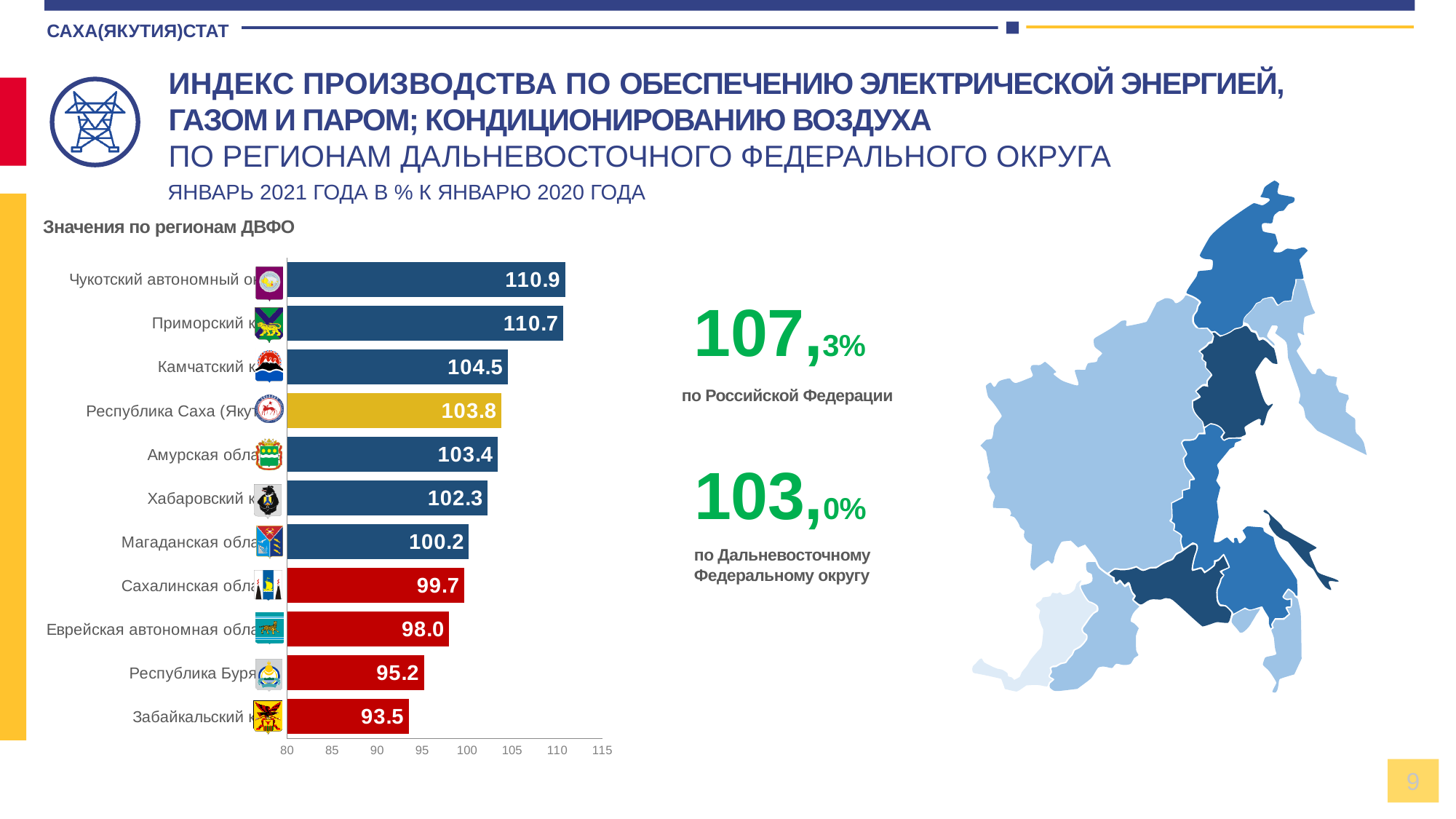
What is the value for Камчатский край in the bar chart? 104.5 How many regions are shown in the bar chart? 11 What is the value for Забайкальский край in the bar chart? 93.5 What kind of chart is shown on the slide? bar chart What is the value for Республика Саха (Якутия) in the bar chart? 103.8 What is the difference between the values for Амурская область and Сахалинская область? 3.7 Which region's bar is coloured yellow in the bar chart? Республика Саха (Якутия) Is the value for Республика Бурятия greater or less than 100? less Which region has the lowest value in the bar chart? Забайкальский край What is the value shown for the Russian Federation (по Российской Федерации) on the slide? 107,3% Which is larger: the value for Хабаровский край or the value for Магаданская область? Хабаровский край Which region has the highest value in the bar chart? Чукотский автономный округ